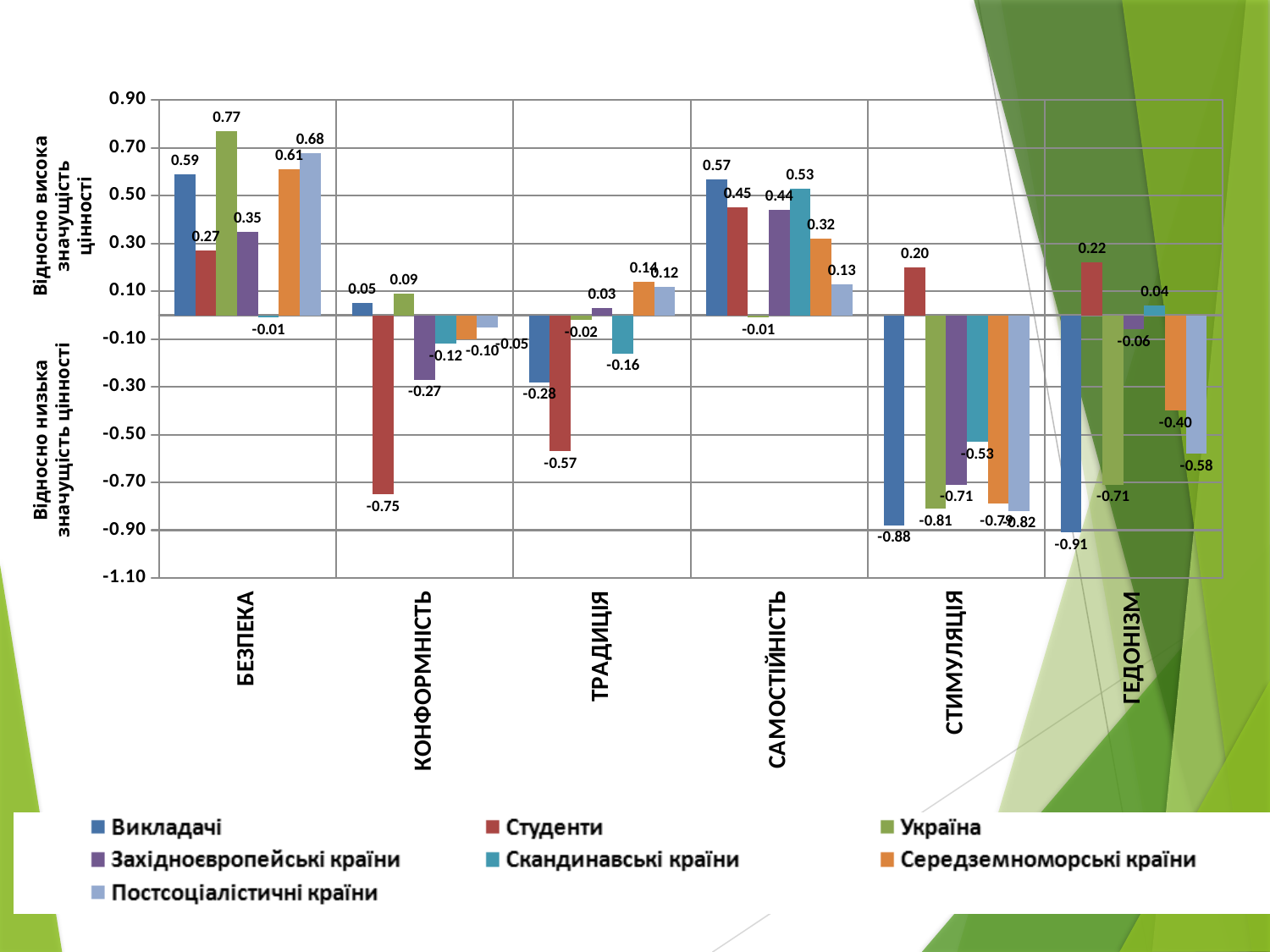
What is the value for Студенти in the КОНФОРМНІСТЬ category? -0.75 Which series has the highest value in the БЕЗПЕКА category? Україна How many series does the legend list? 7 What is the value for Студенти in the ГЕДОНІЗМ category? 0.22 In the САМОСТІЙНІСТЬ category, which is larger: the value for Скандинавські країни or for Середземноморські країни? Скандинавські країни Which series has the lowest value in the ГЕДОНІЗМ category? Викладачі What kind of chart is shown on the slide? bar chart What is the value for Україна in the БЕЗПЕКА category? 0.77 How many value categories are shown along the x axis? 6 What is the value for Викладачі in the СТИМУЛЯЦІЯ category? -0.88 What is the label on the upper part of the vertical axis? Відносно висока значущість цінності What is the difference between the values for Викладачі and Студенти in the БЕЗПЕКА category? 0.32